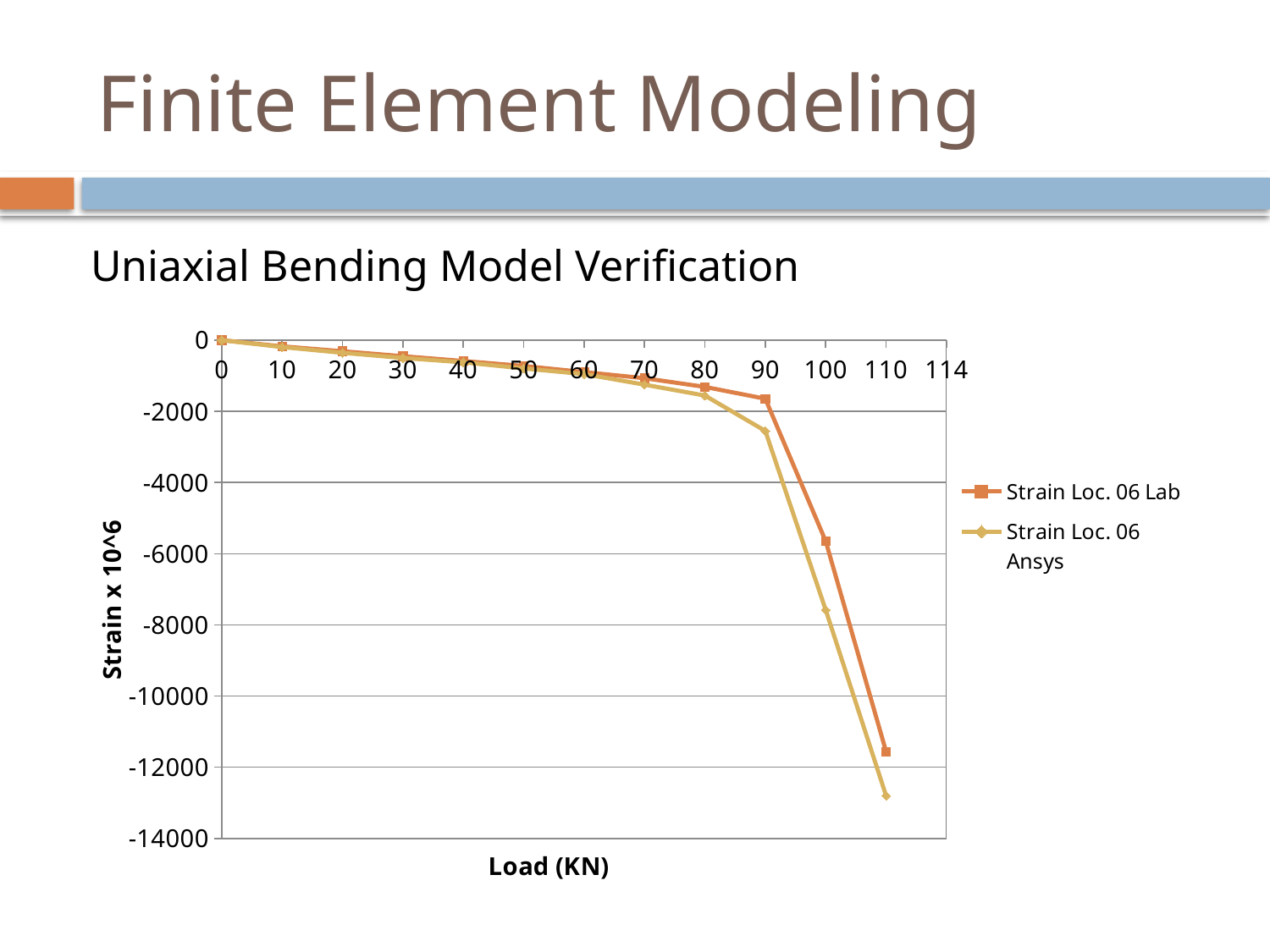
At a load of 100 KN, which series has the more negative strain value, Strain Loc. 06 Lab or Strain Loc. 06 Ansys? Strain Loc. 06 Ansys Is the value for Strain Loc. 06 Ansys at a load of 110 KN greater or less than -12000? less What is the value of Strain Loc. 06 Lab at a load of 0 KN? 0 What kind of chart is shown on the slide? line chart At a load of 110 KN, which series has the more negative strain value, Strain Loc. 06 Lab or Strain Loc. 06 Ansys? Strain Loc. 06 Ansys How many series does the legend list? 2 Is the value for Strain Loc. 06 Lab at a load of 110 KN greater or less than -10000? less What is the label of the y axis? Strain x 10^6 What is the label of the x axis? Load (KN) Is the value for Strain Loc. 06 Ansys at a load of 90 KN greater or less than -2000? less Do the strain values rise or fall as the load increases along the x axis? fall